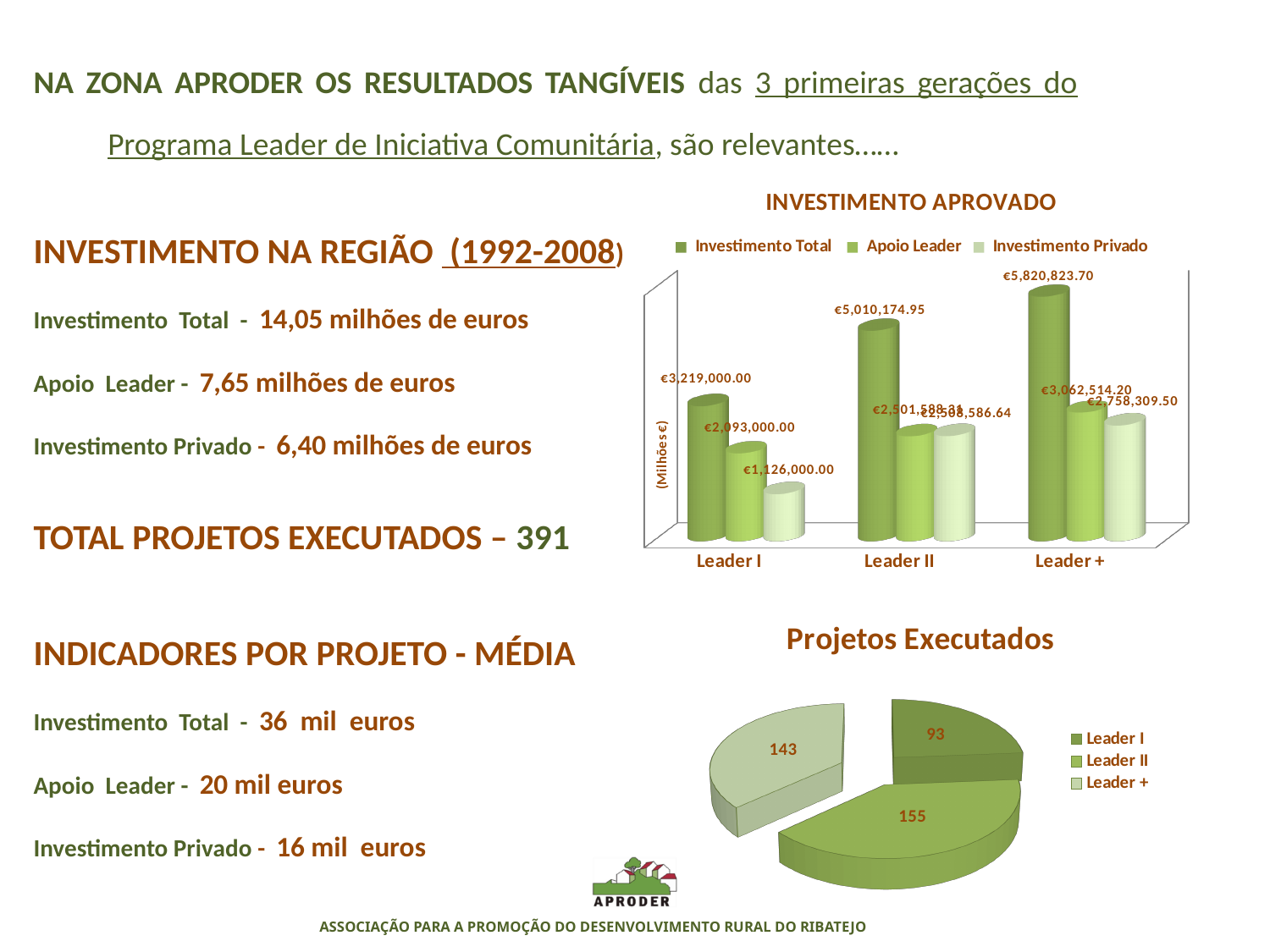
In the INVESTIMENTO APROVADO chart, does the Investimento Total rise or fall from Leader I to Leader +? rise In the INVESTIMENTO APROVADO chart, what is the Investimento Privado value for Leader I? €1,126,000.00 In the Projetos Executados pie chart, how many slices are there? 3 In the INVESTIMENTO APROVADO chart, what is the Investimento Total value for Leader +? €5,820,823.70 In the INVESTIMENTO APROVADO chart, which category has the highest Investimento Total? Leader + What kind of chart is the INVESTIMENTO APROVADO chart? bar chart In the INVESTIMENTO APROVADO chart, what is the Apoio Leader value for Leader +? €3,062,514.20 In the Projetos Executados pie chart, how many projects does Leader II have? 155 In the Projetos Executados pie chart, what is the difference between Leader II and Leader I? 62 In the Projetos Executados pie chart, which slice is the smallest? Leader I In the INVESTIMENTO APROVADO chart, how many series does the legend list? 3 In the INVESTIMENTO APROVADO chart, which category has the lowest Investimento Privado? Leader I